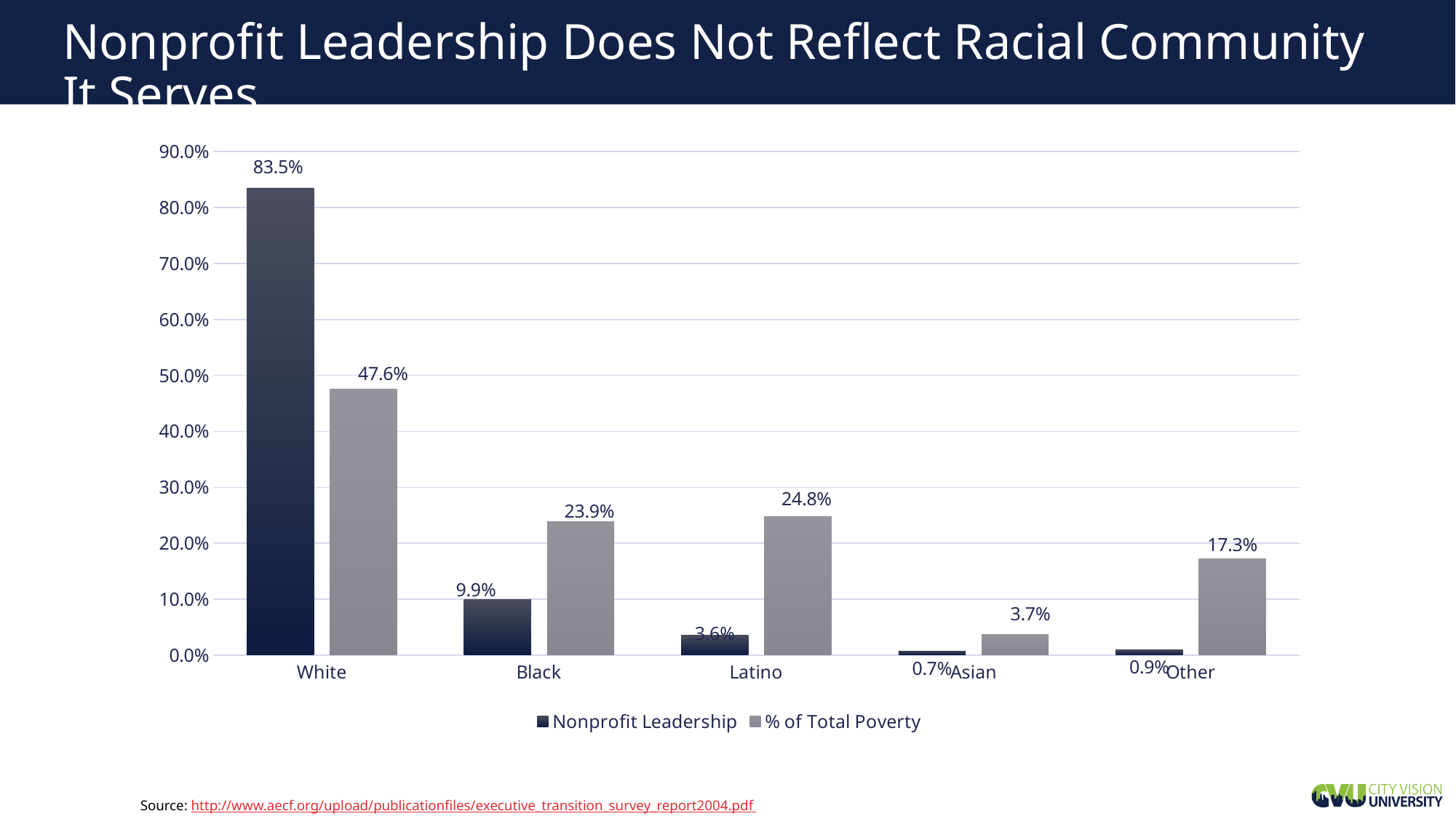
Which is larger for Black: Nonprofit Leadership or % of Total Poverty? % of Total Poverty What is the difference between the Nonprofit Leadership and % of Total Poverty values for White? 35.9% Which category has the lowest Nonprofit Leadership value? Asian Which series is shown in dark navy bars? Nonprofit Leadership What is the % of Total Poverty value for Latino? 24.8% How many series does the legend list? 2 What is the Nonprofit Leadership value for Black? 9.9% What is the % of Total Poverty value for Other? 17.3% What kind of chart is shown on the slide? Bar chart Which category has the highest % of Total Poverty value? White What is the Nonprofit Leadership value for White? 83.5% How many categories are shown on the x axis? 5